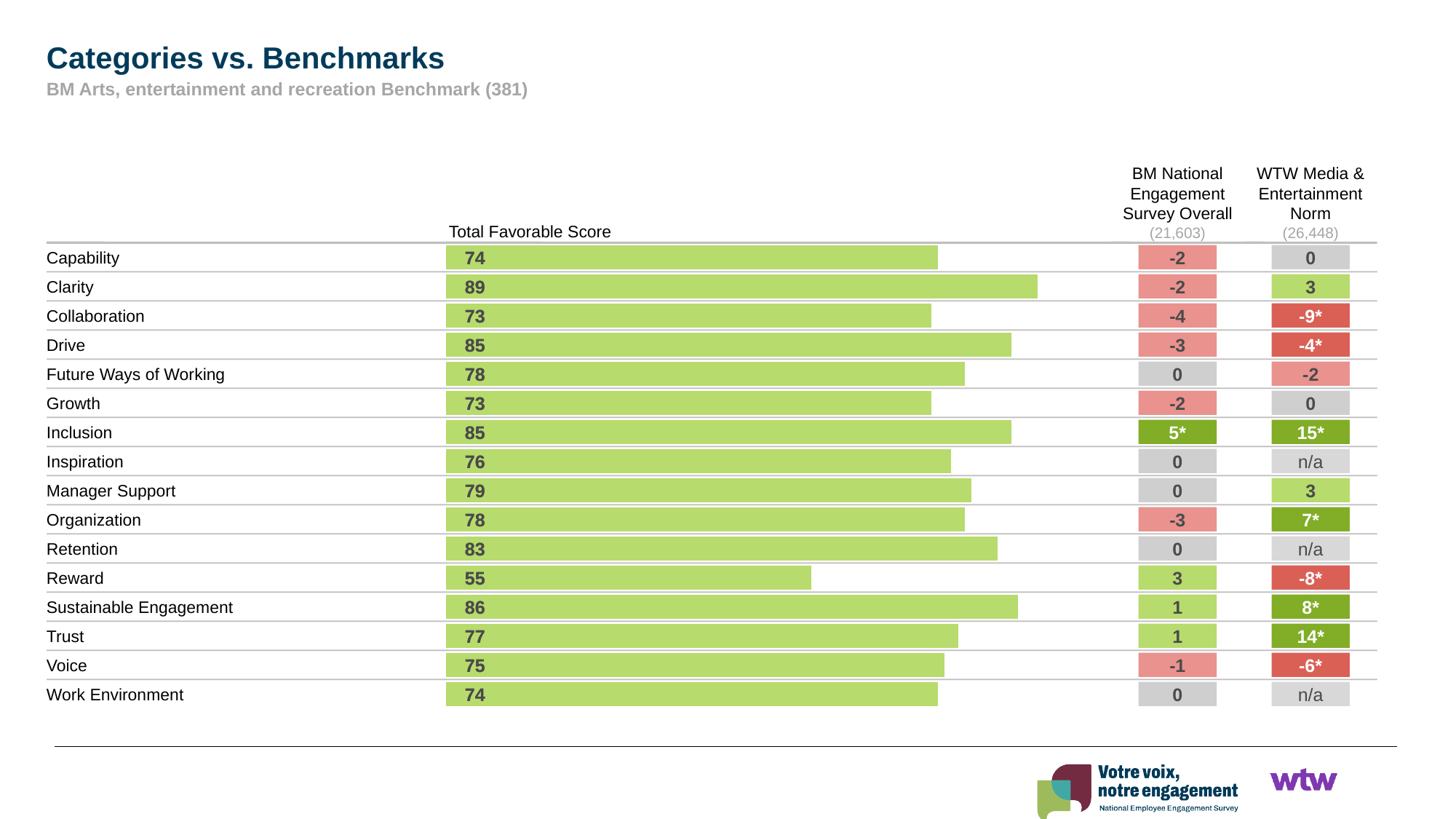
How many categories are shown in the chart? 16 What is the title of the slide? Categories vs. Benchmarks Which category has the highest Total Favorable Score? Clarity What is the difference shown for Inclusion against the WTW Media & Entertainment Norm? 15* Which has a higher Total Favorable Score, Drive or Retention? Drive What is the difference shown for Collaboration against the BM National Engagement Survey Overall? -4 Which category has the lowest Total Favorable Score? Reward What is the Total Favorable Score for Sustainable Engagement? 86 What is the difference between the Total Favorable Scores for Clarity and Reward? 34 What kind of chart is used to show the Total Favorable Scores? Bar chart What is the Total Favorable Score for Reward? 55 What is the Total Favorable Score for Clarity? 89